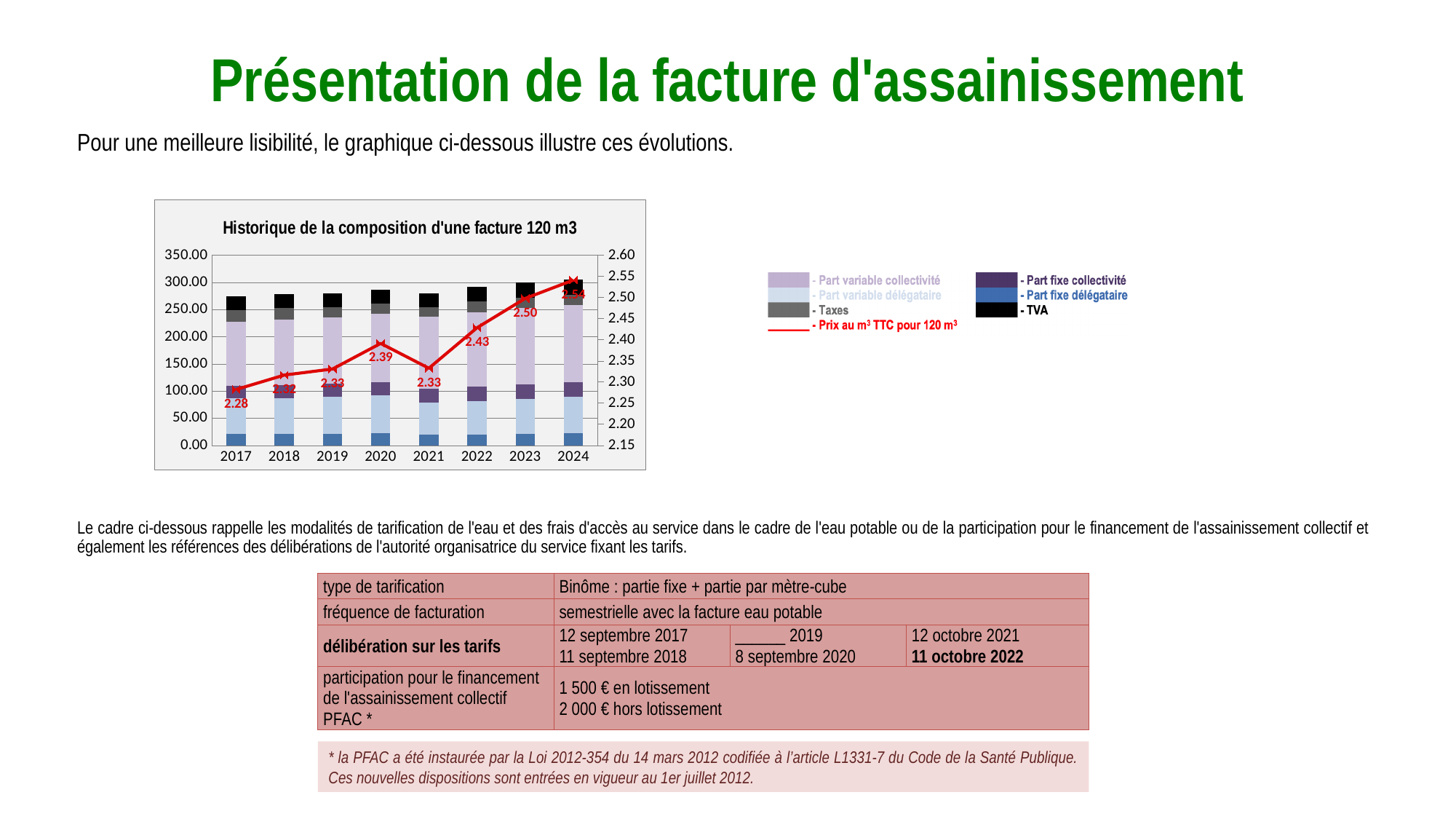
How many series does the chart legend list? 7 In which year is the 'Prix au m³ TTC pour 120 m³' line lowest? 2017 Which year has the higher 'Prix au m³ TTC pour 120 m³' value, 2020 or 2021? 2020 In which year is the 'Prix au m³ TTC pour 120 m³' line highest? 2024 What kind of chart is shown on the slide? A stacked bar chart combined with a line chart What is the value of 'Prix au m³ TTC pour 120 m³' for 2024? 2.54 How many years are shown on the x axis of the chart? 8 What is the value of 'Prix au m³ TTC pour 120 m³' for 2020? 2.39 What is the title of the chart? Historique de la composition d'une facture 120 m3 Is the total height of the stacked bar for 2017 greater or less than 250? greater What is the value of 'Prix au m³ TTC pour 120 m³' for 2017? 2.28 What is the difference between the 'Prix au m³ TTC pour 120 m³' values for 2024 and 2017? 0.26